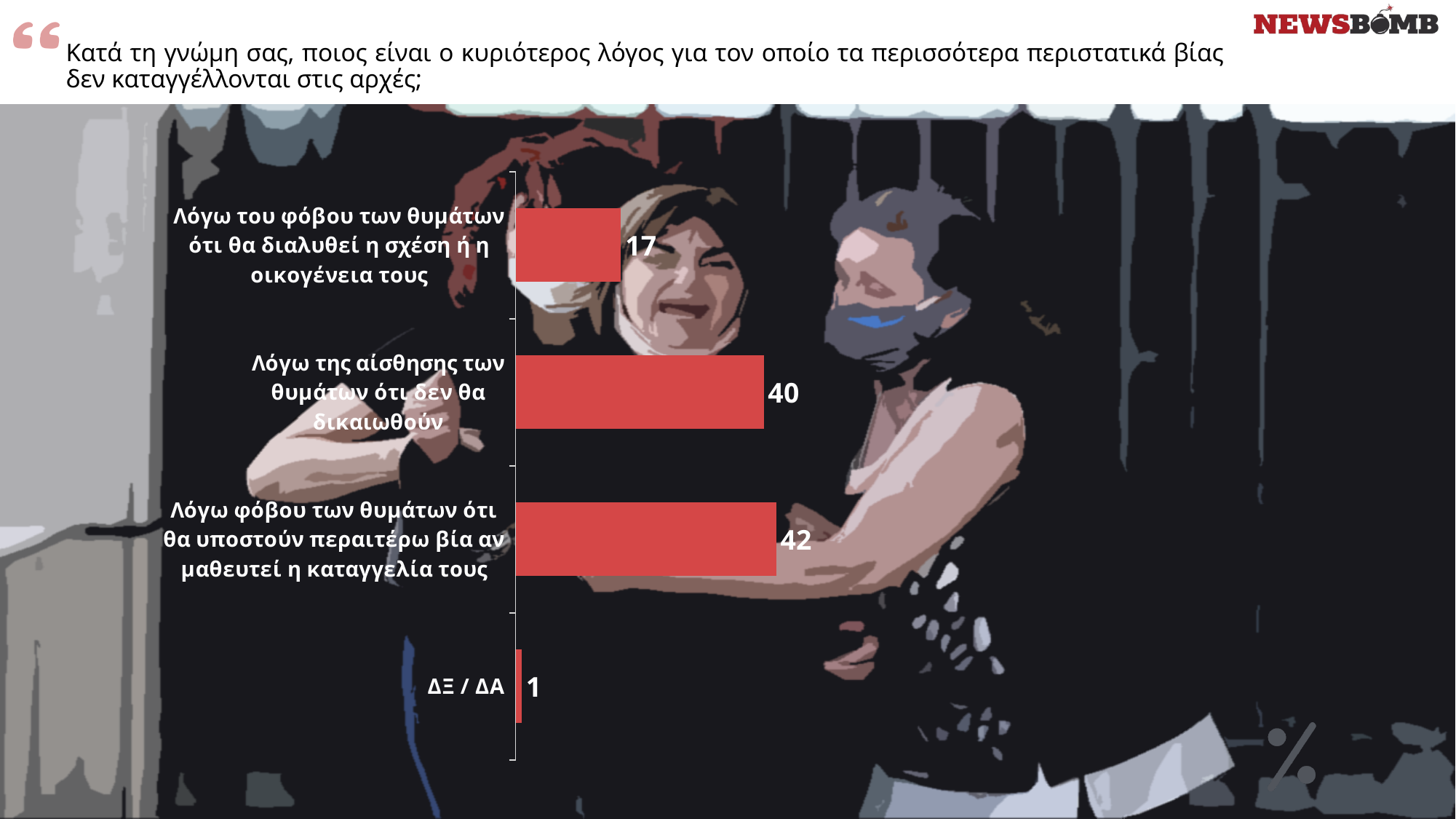
What is the value for "Λόγω φόβου των θυμάτων ότι θα υποστούν περαιτέρω βία αν μαθευτεί η καταγγελία τους"? 42 What is the difference between the values for "Λόγω της αίσθησης των θυμάτων ότι δεν θα δικαιωθούν" and "Λόγω του φόβου των θυμάτων ότι θα διαλυθεί η σχέση ή η οικογένεια τους"? 23 What is the value for "Λόγω του φόβου των θυμάτων ότι θα διαλυθεί η σχέση ή η οικογένεια τους"? 17 Which is larger: the value for "Λόγω του φόβου των θυμάτων ότι θα διαλυθεί η σχέση ή η οικογένεια τους" or the value for "Λόγω της αίσθησης των θυμάτων ότι δεν θα δικαιωθούν"? Λόγω της αίσθησης των θυμάτων ότι δεν θα δικαιωθούν What kind of chart is shown on the slide? Bar chart What is the value for "ΔΞ / ΔΑ"? 1 What is the difference between the values for "Λόγω φόβου των θυμάτων ότι θα υποστούν περαιτέρω βία αν μαθευτεί η καταγγελία τους" and "Λόγω της αίσθησης των θυμάτων ότι δεν θα δικαιωθούν"? 2 What is the value for "Λόγω της αίσθησης των θυμάτων ότι δεν θα δικαιωθούν"? 40 What colour are the bars in the chart? Red How many categories are shown in the chart? 4 Which category has the highest value? Λόγω φόβου των θυμάτων ότι θα υποστούν περαιτέρω βία αν μαθευτεί η καταγγελία τους Which category has the lowest value? ΔΞ / ΔΑ